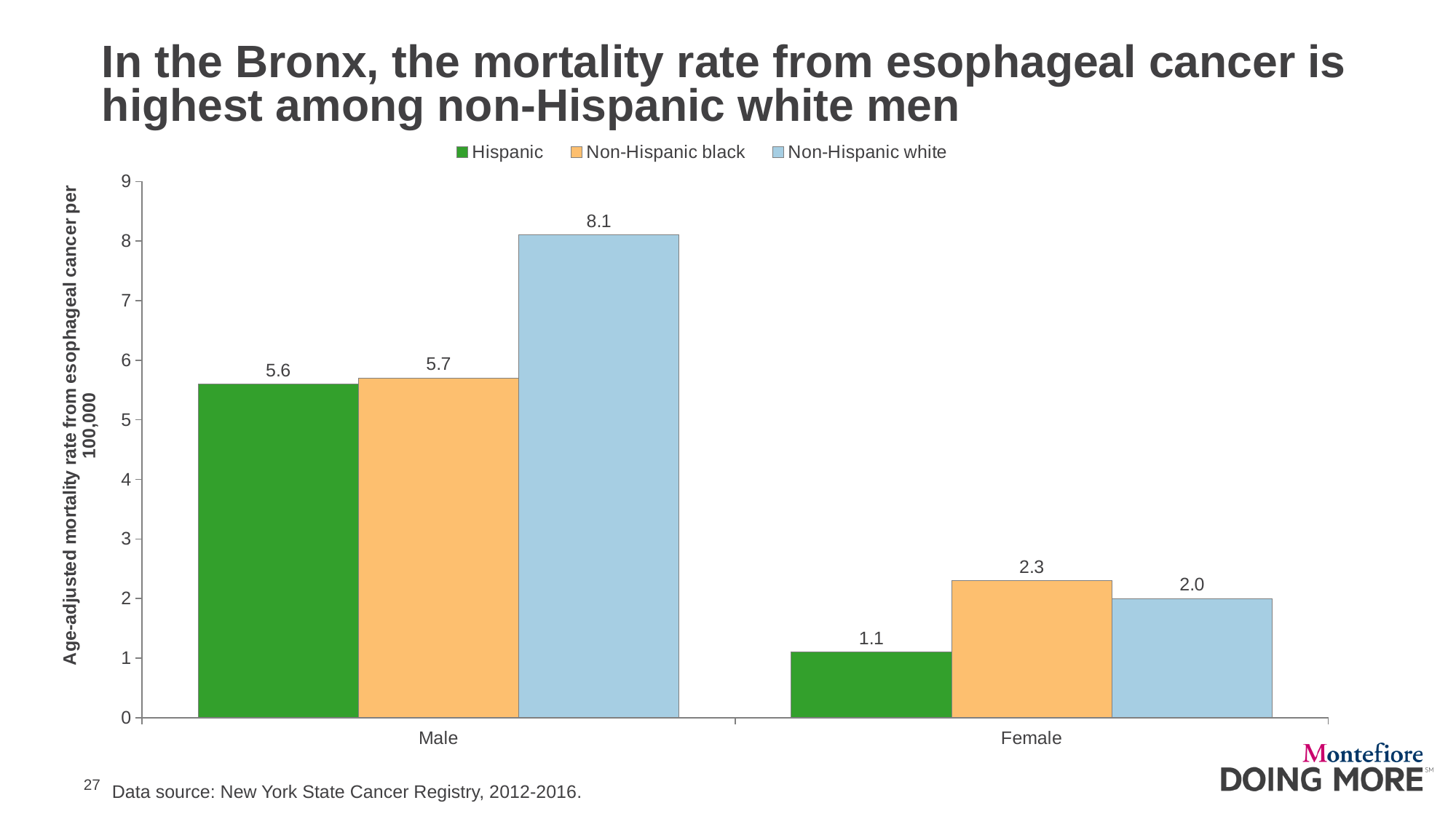
What is the mortality rate for non-Hispanic black females? 2.3 What is the age-adjusted mortality rate from esophageal cancer for Hispanic females? 1.1 Is the mortality rate for Hispanic males greater or less than 5? greater Which is larger: the mortality rate for non-Hispanic black females or non-Hispanic white females? Non-Hispanic black females What is the difference between the mortality rate for non-Hispanic black females and Hispanic females? 1.2 How many series does the legend list? 3 Which colour represents the Hispanic series in the chart? Green What is the difference between the mortality rate for non-Hispanic white males and non-Hispanic white females? 6.1 What kind of chart is shown on the slide? Bar chart What is the age-adjusted mortality rate from esophageal cancer for non-Hispanic white males? 8.1 Which group has the lowest mortality rate among females? Hispanic Which group has the highest mortality rate among males? Non-Hispanic white